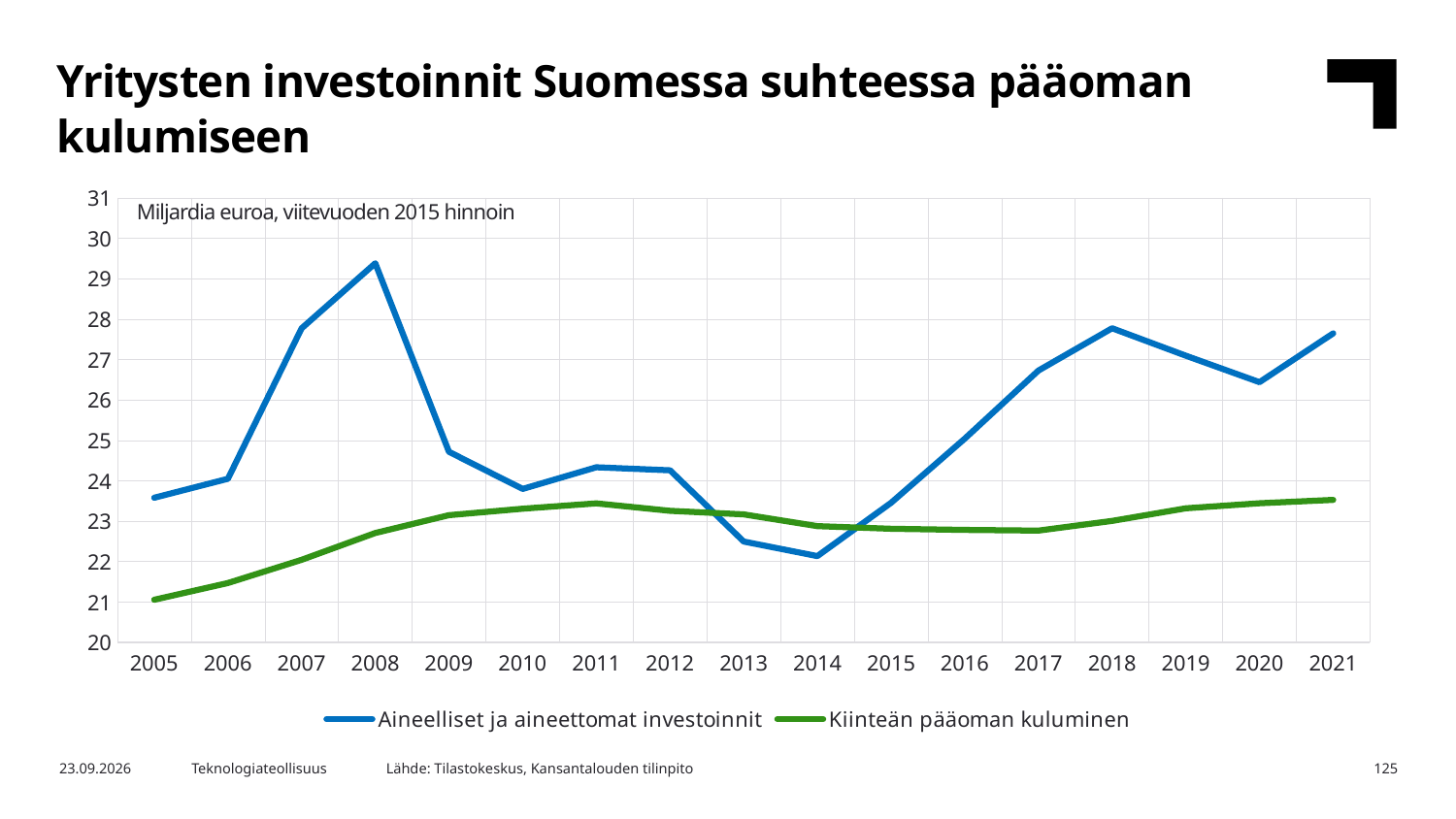
Does the series 'Aineelliset ja aineettomat investoinnit' rise or fall between 2014 and 2018? rise Is the value for 'Aineelliset ja aineettomat investoinnit' in 2018 greater or less than 27? greater Is the value for 'Kiinteän pääoman kuluminen' in 2005 greater or less than 22? less What unit description is printed inside the plot area of the chart? Miljardia euroa, viitevuoden 2015 hinnoin What kind of chart is shown on the slide? line chart In which year is the series 'Kiinteän pääoman kuluminen' at its lowest value? 2005 In 2014, which series has the larger value: 'Aineelliset ja aineettomat investoinnit' or 'Kiinteän pääoman kuluminen'? Kiinteän pääoman kuluminen How many series does the legend list? 2 Is the value for 'Aineelliset ja aineettomat investoinnit' in 2008 greater or less than 29? greater In which year does the series 'Aineelliset ja aineettomat investoinnit' reach its highest value? 2008 How many years are plotted along the x axis? 17